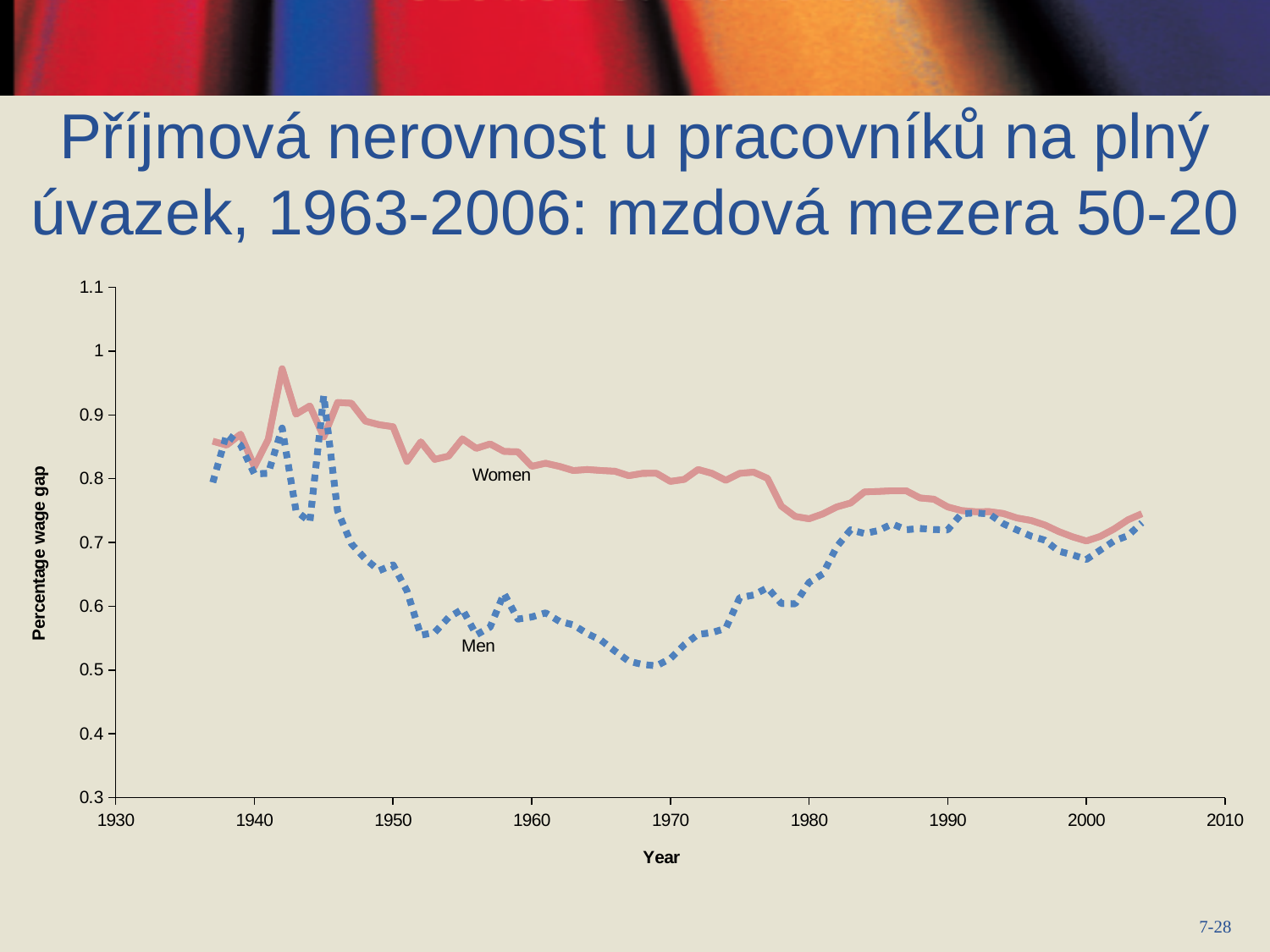
What kind of chart is shown on the slide? Line chart How many series are plotted on the chart? 2 What is the title of the vertical axis? Percentage wage gap Does the Women line generally rise or fall between 1950 and 2000? Fall Is the value for Men around 1970 greater or less than 0.6? less Is the value for Men around 1990 greater or less than 0.7? greater What are the two series labelled on the chart? Women and Men Is the value for Women around 1980 greater or less than 0.8? less Which series reaches the lowest value anywhere on the chart? Men Which series reaches the highest value anywhere on the chart? Women Around 1970, which series has the higher value, Women or Men? Women